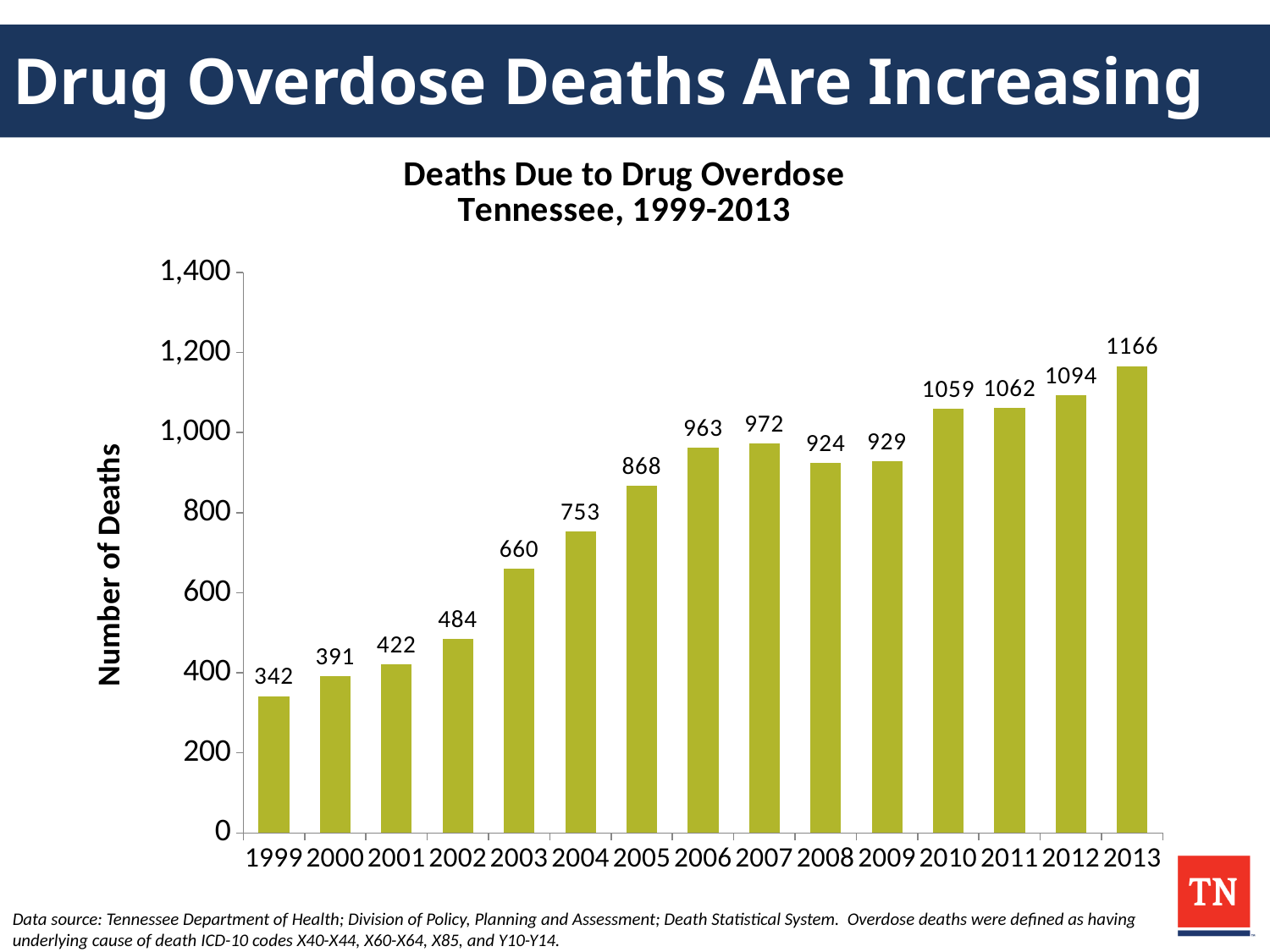
What is the title of the chart? Deaths Due to Drug Overdose Tennessee, 1999-2013 Which year had more drug overdose deaths, 2007 or 2008? 2007 Do the number of drug overdose deaths generally rise or fall from 1999 to 2013? Rise How many years are shown on the x axis of the chart? 15 What is the label of the y axis? Number of Deaths What is the number of deaths due to drug overdose in Tennessee in 2003? 660 What kind of chart is shown on the slide? Bar chart Which year has the lowest number of drug overdose deaths? 1999 Is the value for 2005 greater or less than 800? greater What is the number of deaths due to drug overdose in Tennessee in 2013? 1166 Which year has the highest number of drug overdose deaths? 2013 What is the difference in drug overdose deaths between 2013 and 1999? 824